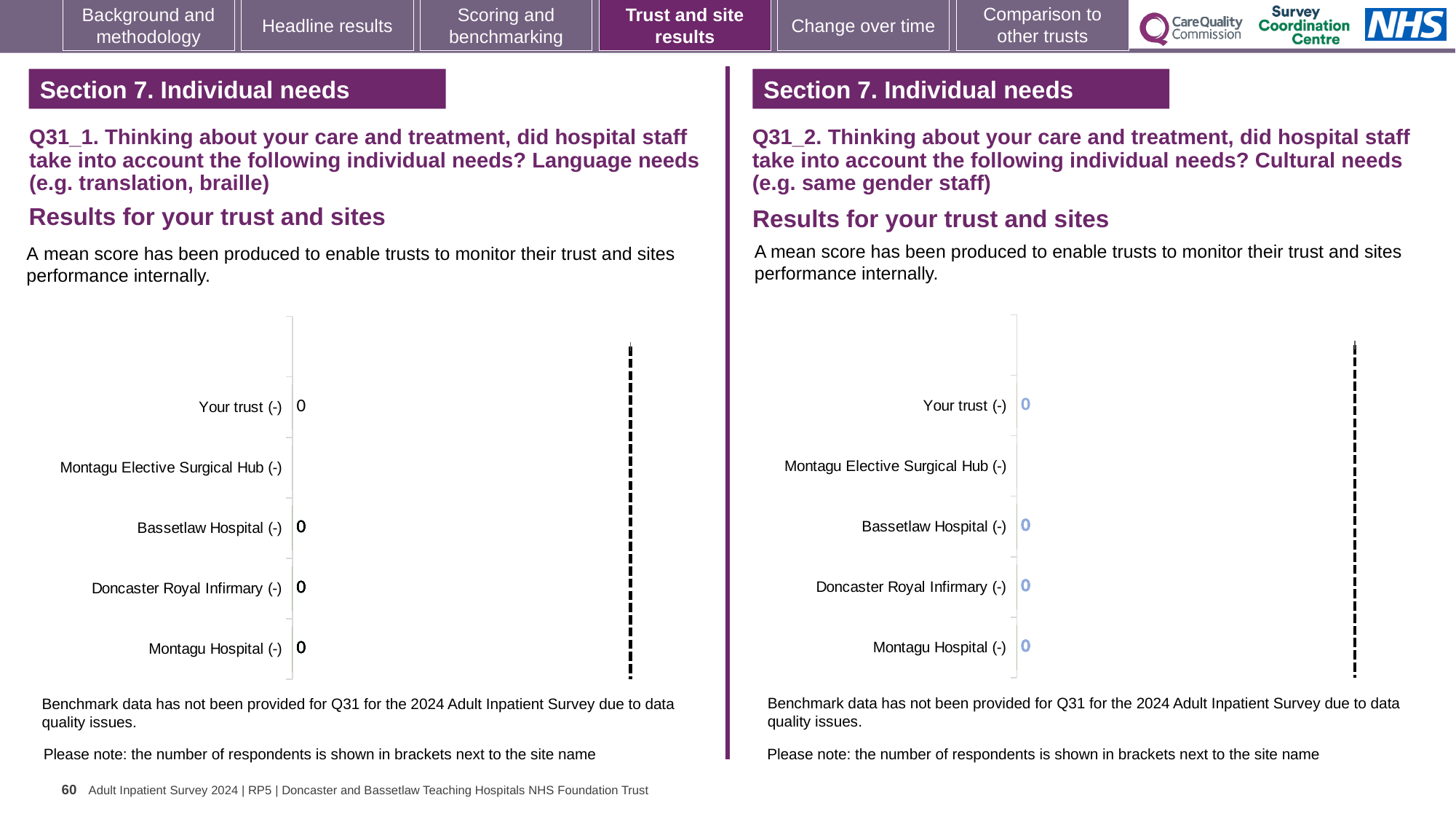
In the left chart (Q31_1, Language needs), what is the difference between the values for Bassetlaw Hospital and Montagu Hospital? 0 In the right chart (Q31_2, Cultural needs), what is the value shown for Montagu Hospital? 0 What kind of chart is the left chart (Q31_1, Language needs)? Bar chart Which section heading appears above both charts on the slide? Section 7. Individual needs In the right chart (Q31_2, Cultural needs), what is the value shown for Doncaster Royal Infirmary? 0 In the left chart (Q31_1, Language needs), what is the value shown for Doncaster Royal Infirmary? 0 In the right chart (Q31_2, Cultural needs), what is the value shown for Your trust? 0 Which category in the right chart (Q31_2, Cultural needs) has no data label shown next to it? Montagu Elective Surgical Hub (-) How many categories are listed on the vertical axis of the right chart (Q31_2, Cultural needs)? 5 How many categories are listed on the vertical axis of the left chart (Q31_1, Language needs)? 5 In the left chart (Q31_1, Language needs), what is the value shown for Bassetlaw Hospital? 0 In the left chart (Q31_1, Language needs), what is the value shown for Your trust? 0